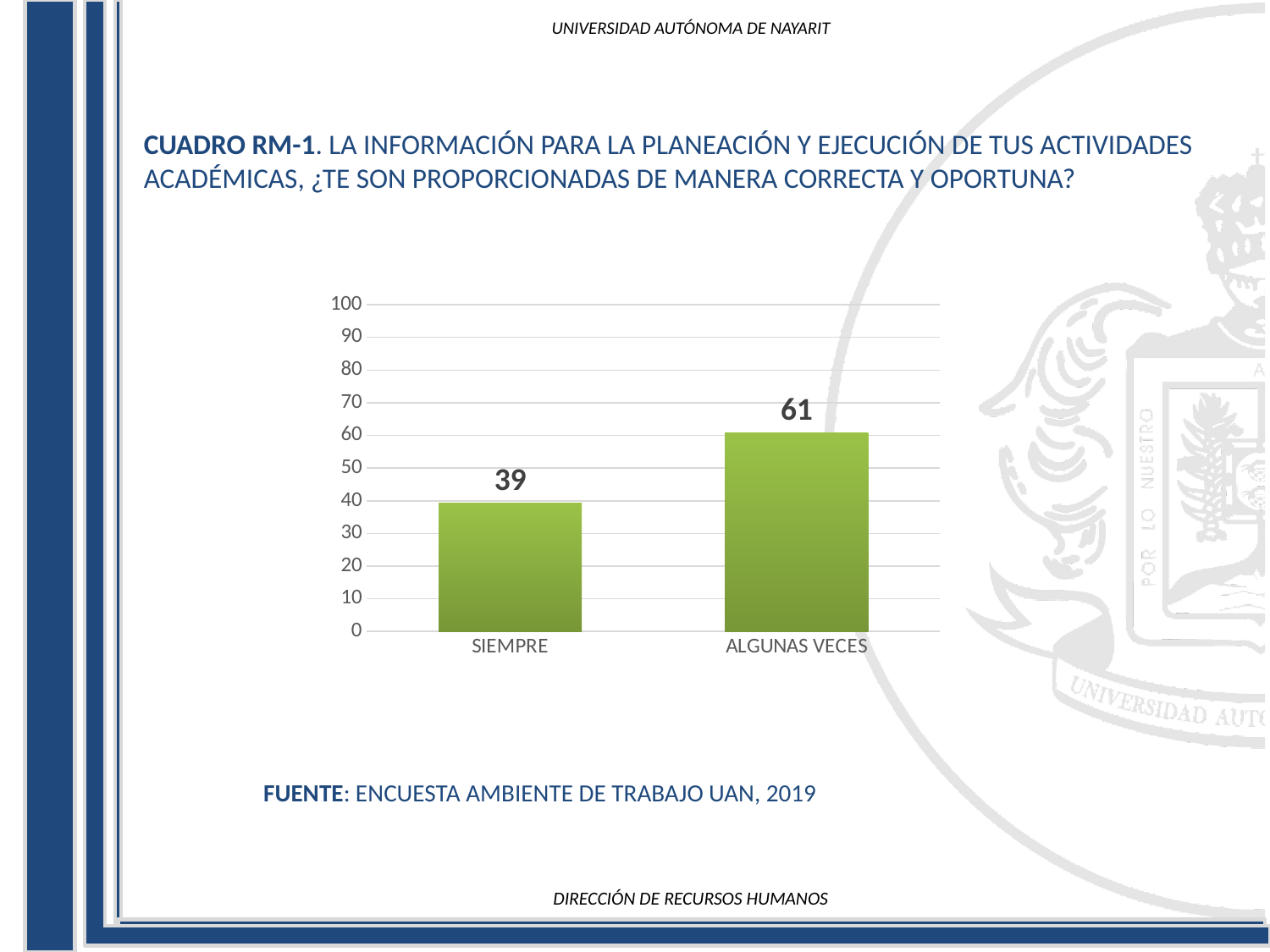
What is the maximum value shown on the vertical axis? 100 What is the difference between the values for ALGUNAS VECES and SIEMPRE? 22 How many categories are shown on the x axis? 2 Is the value for ALGUNAS VECES greater or less than 50? greater What is the total of the two values shown in the chart? 100 Which category has the lowest value? SIEMPRE What kind of chart is shown on the slide? bar chart Which is larger, the value for SIEMPRE or the value for ALGUNAS VECES? ALGUNAS VECES Is the value for SIEMPRE greater or less than 50? less What is the value for ALGUNAS VECES? 61 Which category has the highest value? ALGUNAS VECES What is the value for SIEMPRE? 39